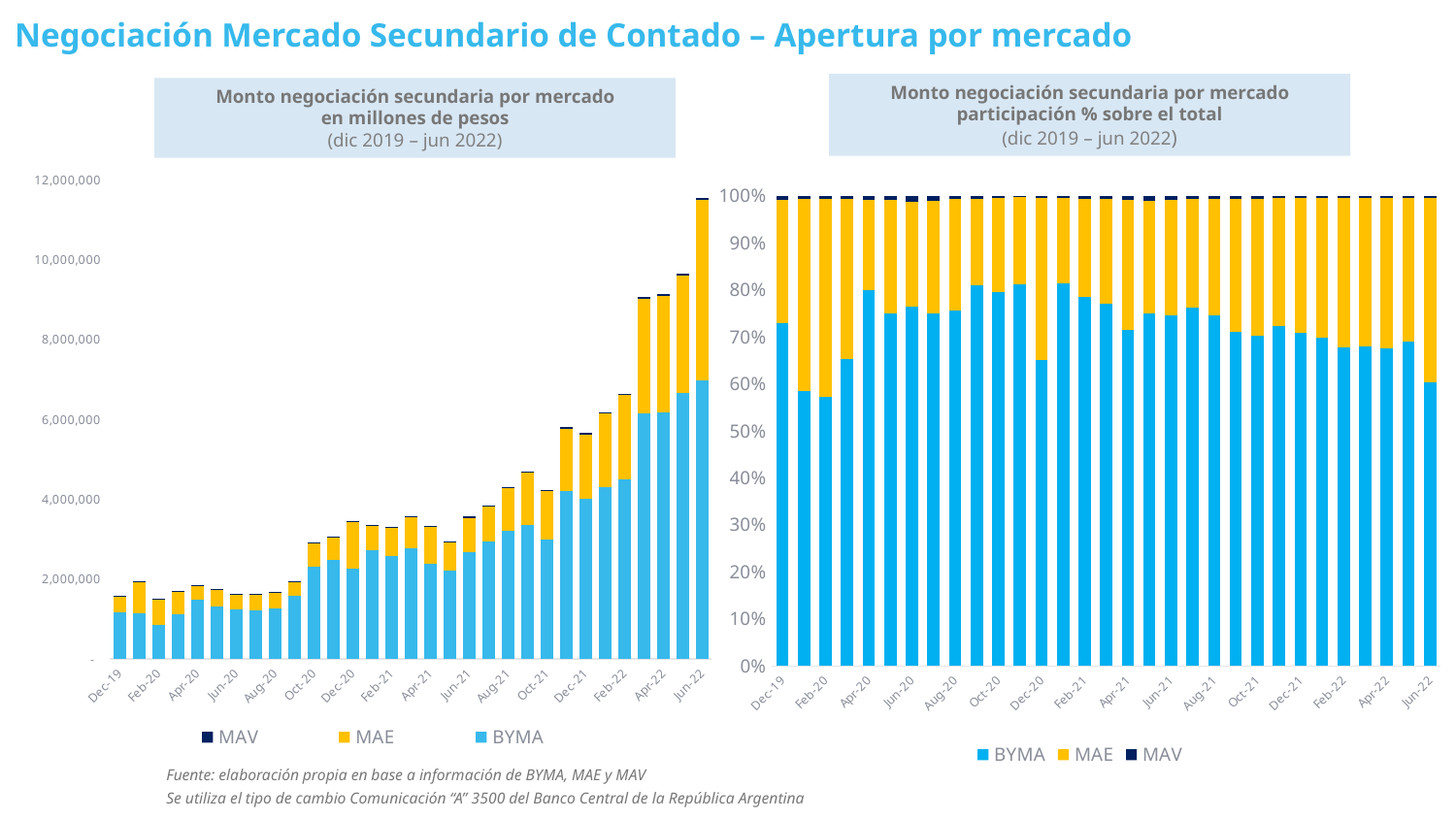
In the right chart (participación % sobre el total), is the BYMA share for Jun-22 greater or less than 70%? less In the right chart (participación % sobre el total), is the BYMA share for Feb-20 greater or less than 60%? less In the right chart (participación % sobre el total), which is larger for Jun-22: the BYMA share or the MAE share? BYMA In the left chart (millones de pesos), is the total for Jun-22 greater or less than 10,000,000? greater How many monthly bars does the left chart (millones de pesos) show from Dec-19 to Jun-22? 31 In the left chart (millones de pesos), which month has the highest total bar? Jun-22 What kind of chart is the left chart, 'Monto negociación secundaria por mercado en millones de pesos'? Stacked bar chart Which series are listed in the legend of the left chart (millones de pesos)? MAV, MAE, BYMA How many series does the legend of the right chart, 'participación % sobre el total', list? 3 In the left chart (millones de pesos), do the total bars generally rise or fall from Dec-19 to Jun-22? Rise